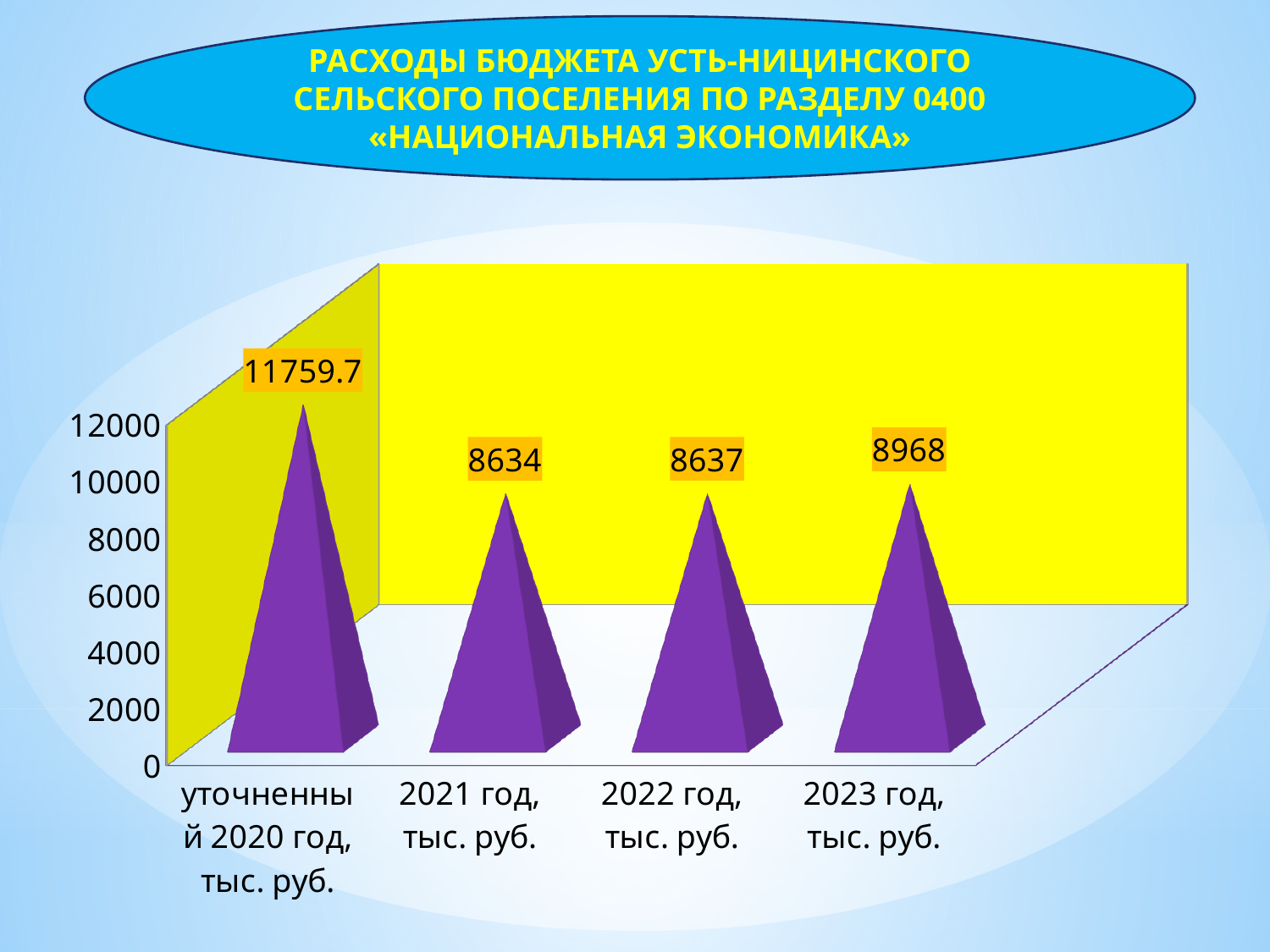
What is the value for 2023 год, тыс. руб.? 8968 Do the values rise or fall from 2021 год to 2023 год? rise What kind of chart is shown on the slide? bar chart Which is larger, the value for 2023 год or the value for 2021 год? 2023 год What is the value for 2021 год, тыс. руб.? 8634 Is the value for 2022 год greater or less than 10000? less What is the difference between the values for уточненный 2020 год and 2021 год? 3125.7 How many categories are shown on the x axis? 4 What is the value for 2022 год, тыс. руб.? 8637 What is the difference between the values for 2023 год and 2022 год? 331 Which category has the highest value? уточненный 2020 год, тыс. руб. What is the value for уточненный 2020 год, тыс. руб.? 11759.7